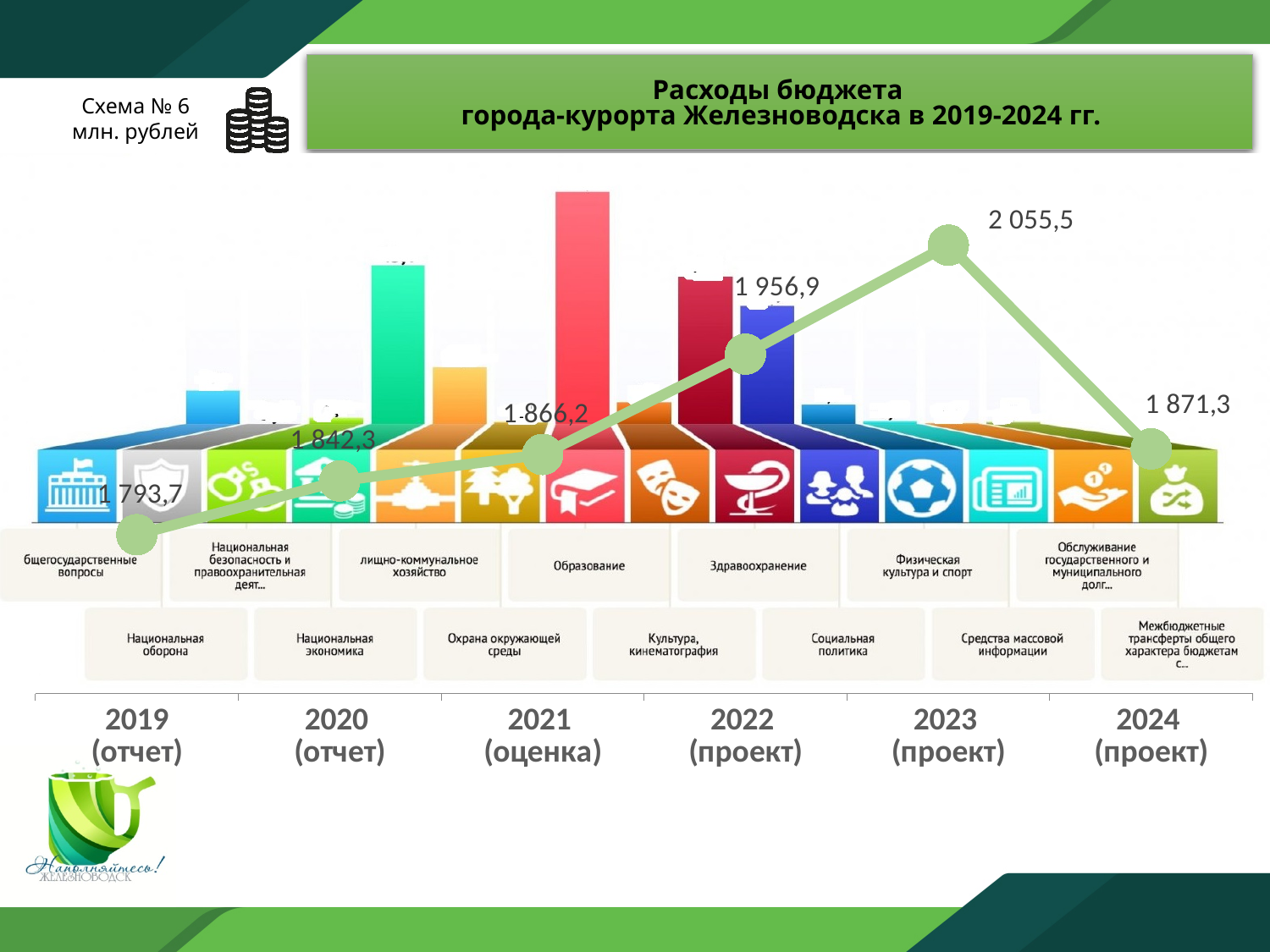
What is the budget expenditure value shown for 2024 (проект)? 1 871,3 Which year has the highest budget expenditure on the line chart? 2023 (проект) Do the budget expenditure values rise or fall from 2019 to 2023? rise What is the budget expenditure value shown for 2019 (отчет)? 1 793,7 What is the difference between the budget expenditure for 2023 and 2024? 184,2 What unit of measurement is stated for the values on the slide? млн. рублей How many years are plotted on the line chart? 6 Which year has the lowest budget expenditure on the line chart? 2019 (отчет) What is the budget expenditure value shown for 2023 (проект)? 2 055,5 What is the budget expenditure value shown for 2021 (оценка)? 1 866,2 Which is larger, the budget expenditure for 2022 or for 2024? 2022 What is the difference between the budget expenditure for 2020 and 2019? 48,6